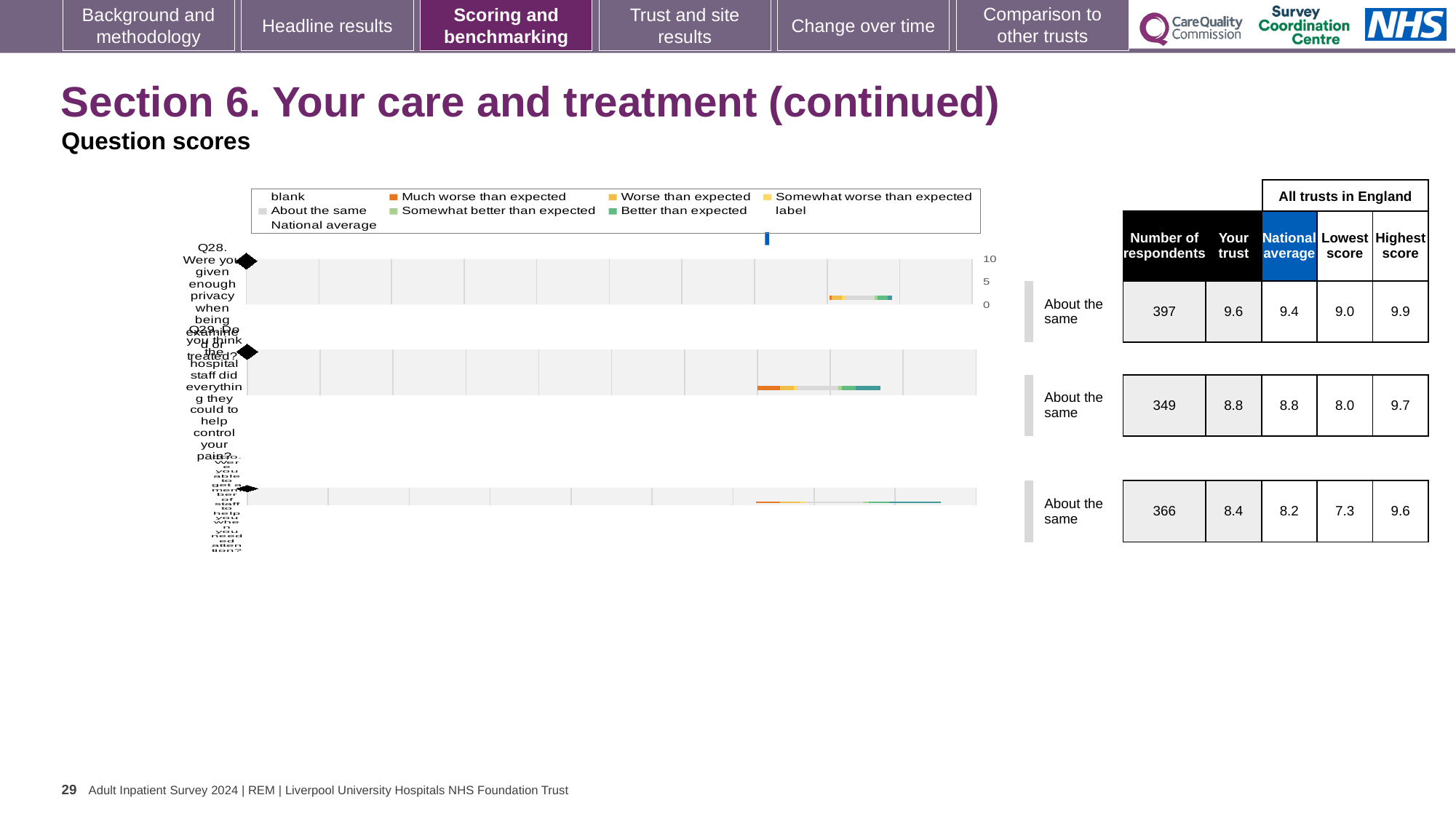
What is the 'Your trust' score for Q28 (privacy when being examined or treated)? 9.6 How many questions (chart rows) are shown on the slide? 3 What is the difference between the highest score and the lowest score for Q30? 2.3 How many respondents answered Q28? 397 Which question has the highest 'Your trust' score? Q28 What benchmark category is shown next to the Q28 chart? About the same What colour represents 'Much worse than expected' in the legend? Orange What kind of chart is used to show the question scores on this slide? Bar chart What is the lowest score among all trusts in England for Q30? 7.3 What is the national average score for Q29 (staff did everything to help control your pain)? 8.8 For Q28, which is larger: the 'Your trust' score or the national average? Your trust Is the 'Your trust' score for Q29 greater or less than 5? greater